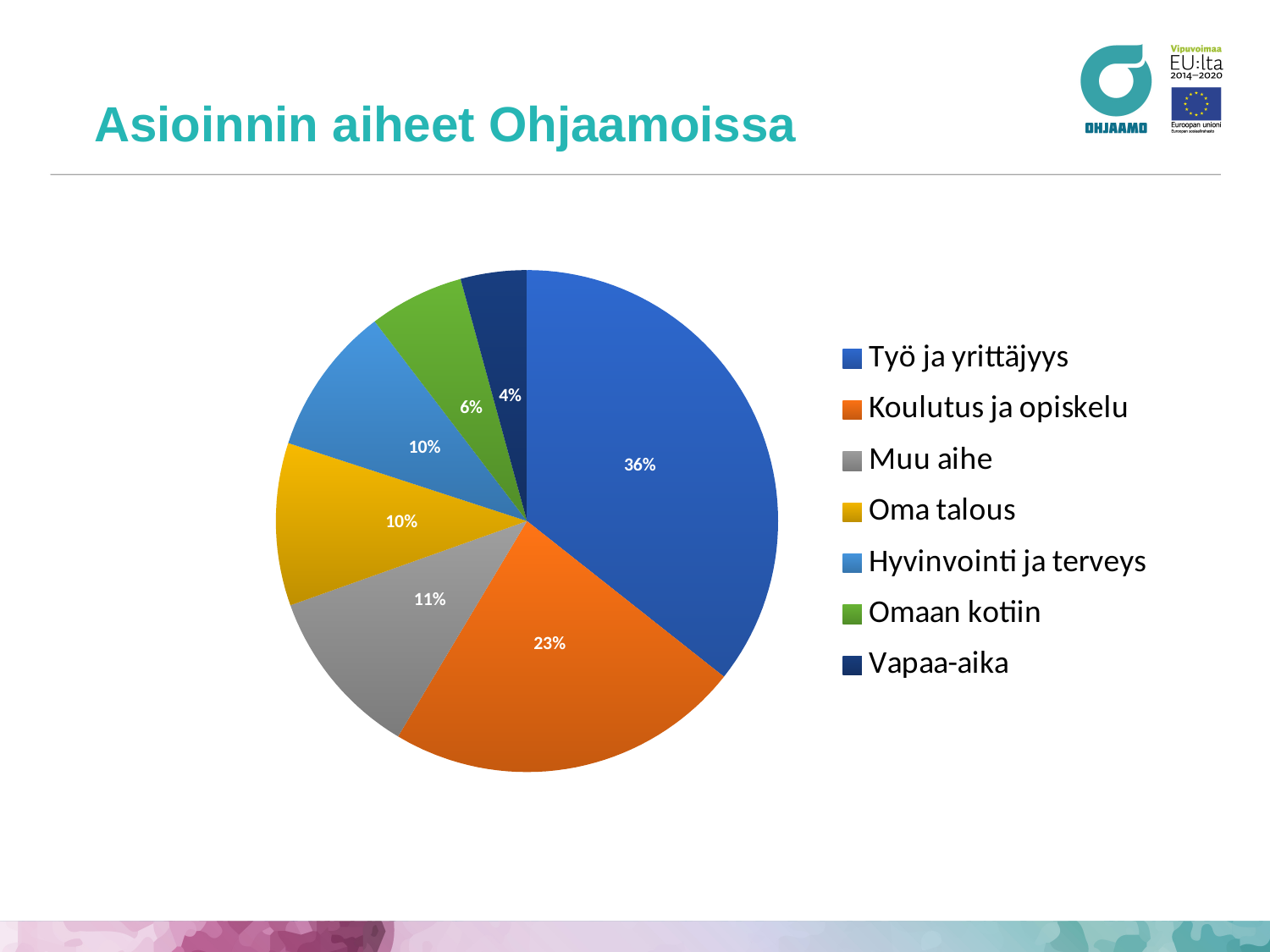
What is the title of the slide containing the pie chart? Asioinnin aiheet Ohjaamoissa Which category has the smallest slice of the pie? Vapaa-aika What is the value for Muu aihe? 11% How many categories does the pie chart have? 7 What is the value for Omaan kotiin? 6% Which is larger, the share for Muu aihe or the share for Omaan kotiin? Muu aihe What is the value for Koulutus ja opiskelu? 23% Which category has the largest slice of the pie? Työ ja yrittäjyys What kind of chart is shown on the slide? Pie chart What colour is the slice for Oma talous? Yellow What is the difference between the shares of Työ ja yrittäjyys and Koulutus ja opiskelu? 13 percentage points What share of the pie does Työ ja yrittäjyys have? 36%